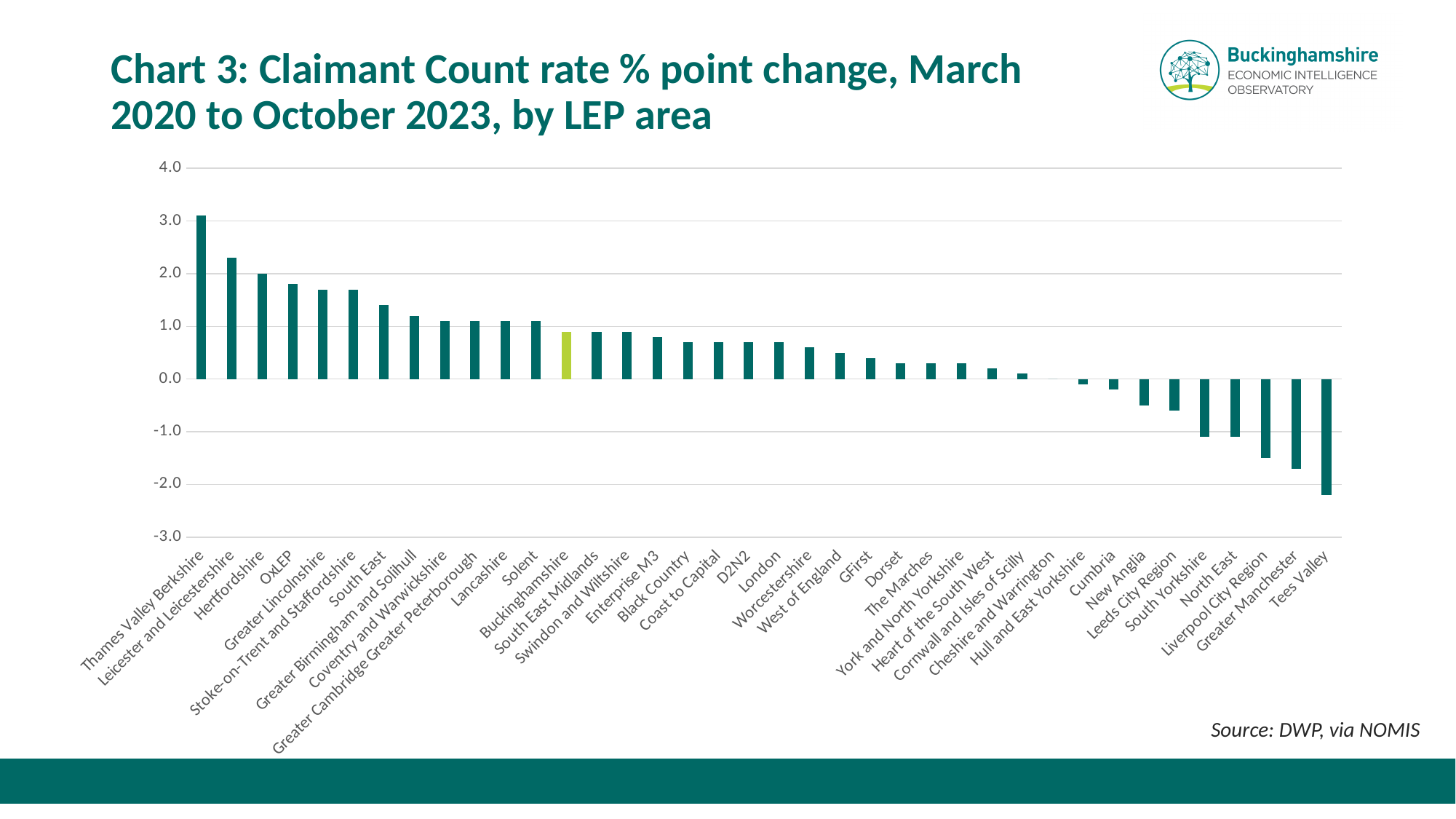
How many LEP areas are labelled on the x axis? 38 Which LEP area has the highest claimant count rate percentage point change? Thames Valley Berkshire Is the value for Leicester and Leicestershire greater or less than 2.0? greater Is the value for Greater Manchester greater or less than -1.0? less Which has the larger value, Greater Manchester or Tees Valley? Greater Manchester Is the value for Tees Valley greater or less than -1.0? less Which LEP area's bar is highlighted in a different colour from the rest? Buckinghamshire Which LEP area has the lowest claimant count rate percentage point change? Tees Valley Do the values rise or fall moving from left to right along the x axis? Fall What kind of chart is shown on the slide? Bar chart Which has the larger value, Hertfordshire or London? Hertfordshire